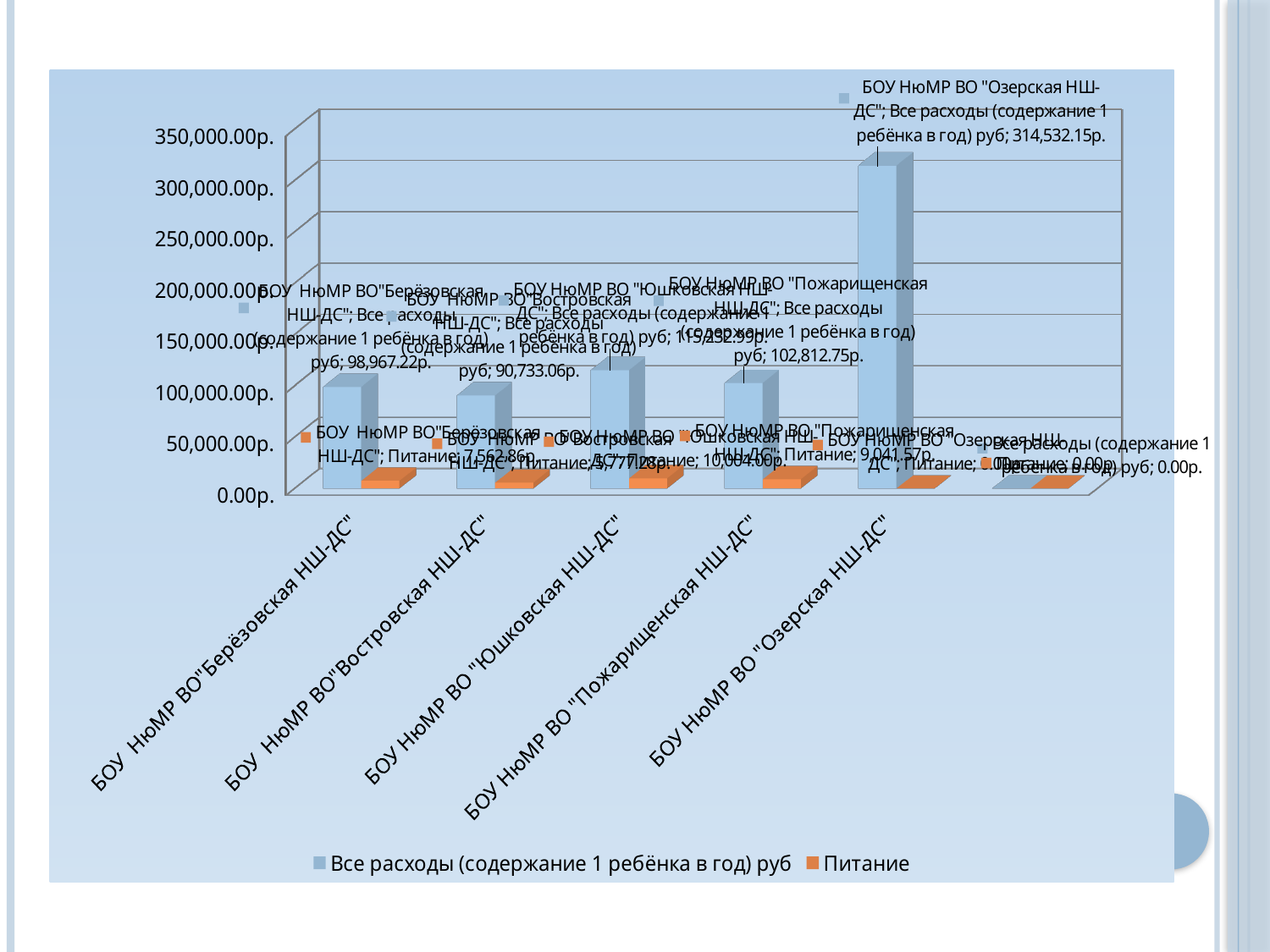
What is the difference in "Все расходы (содержание 1 ребёнка в год) руб" between Озерская НШ-ДС and Берёзовская НШ-ДС? 215,564.93р. What is the value of "Все расходы (содержание 1 ребёнка в год) руб" for БОУ НюМР ВО "Озерская НШ-ДС"? 314,532.15р. What is the value of "Питание" for БОУ НюМР ВО "Берёзовская НШ-ДС"? 7,562.86р. What kind of chart is shown on the slide? bar chart What is the value of "Питание" for БОУ НюМР ВО "Озерская НШ-ДС"? 0.00р. What is the value of "Питание" for БОУ НюМР ВО "Пожарищенская НШ-ДС"? 9,041.57р. Which school has the highest value for "Все расходы (содержание 1 ребёнка в год) руб"? БОУ НюМР ВО "Озерская НШ-ДС" Which is larger for "Все расходы (содержание 1 ребёнка в год) руб": Берёзовская НШ-ДС or Пожарищенская НШ-ДС? Пожарищенская НШ-ДС What is the value of "Все расходы (содержание 1 ребёнка в год) руб" for БОУ НюМР ВО "Пожарищенская НШ-ДС"? 102,812.75р. How many series does the legend list? 2 What is the value of "Все расходы (содержание 1 ребёнка в год) руб" for БОУ НюМР ВО "Берёзовская НШ-ДС"? 98,967.22р. Is the value of "Все расходы (содержание 1 ребёнка в год) руб" for Озерская НШ-ДС greater or less than 300,000.00р.? greater